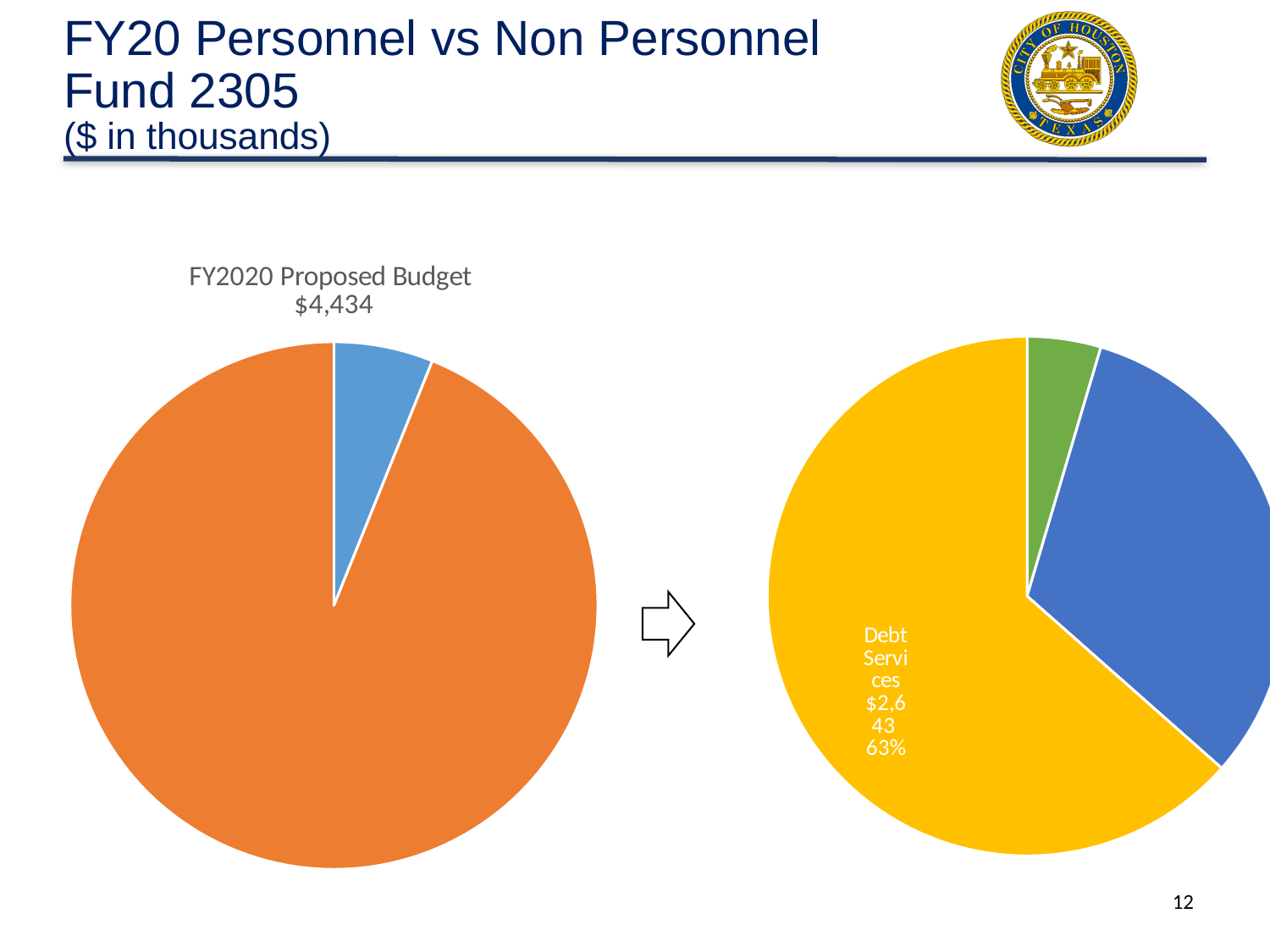
How many slices does the left chart, 'FY2020 Proposed Budget', have? 2 What kind of chart is the left chart titled 'FY2020 Proposed Budget'? pie chart What kind of chart is the chart on the right side of the slide? pie chart What is the title of the left chart? FY2020 Proposed Budget What total amount is shown under the title of the left chart, 'FY2020 Proposed Budget'? $4,434 In the left chart, 'FY2020 Proposed Budget', which slice is larger, the orange one or the blue one? the orange one In the right chart, what share of the pie is Debt Services? 63% In the right chart, which slice is the largest? Debt Services In the right chart, is the share for Debt Services greater or less than 50%? greater In the right chart, what is the value for Debt Services? $2,643 How many slices does the right chart have? 3